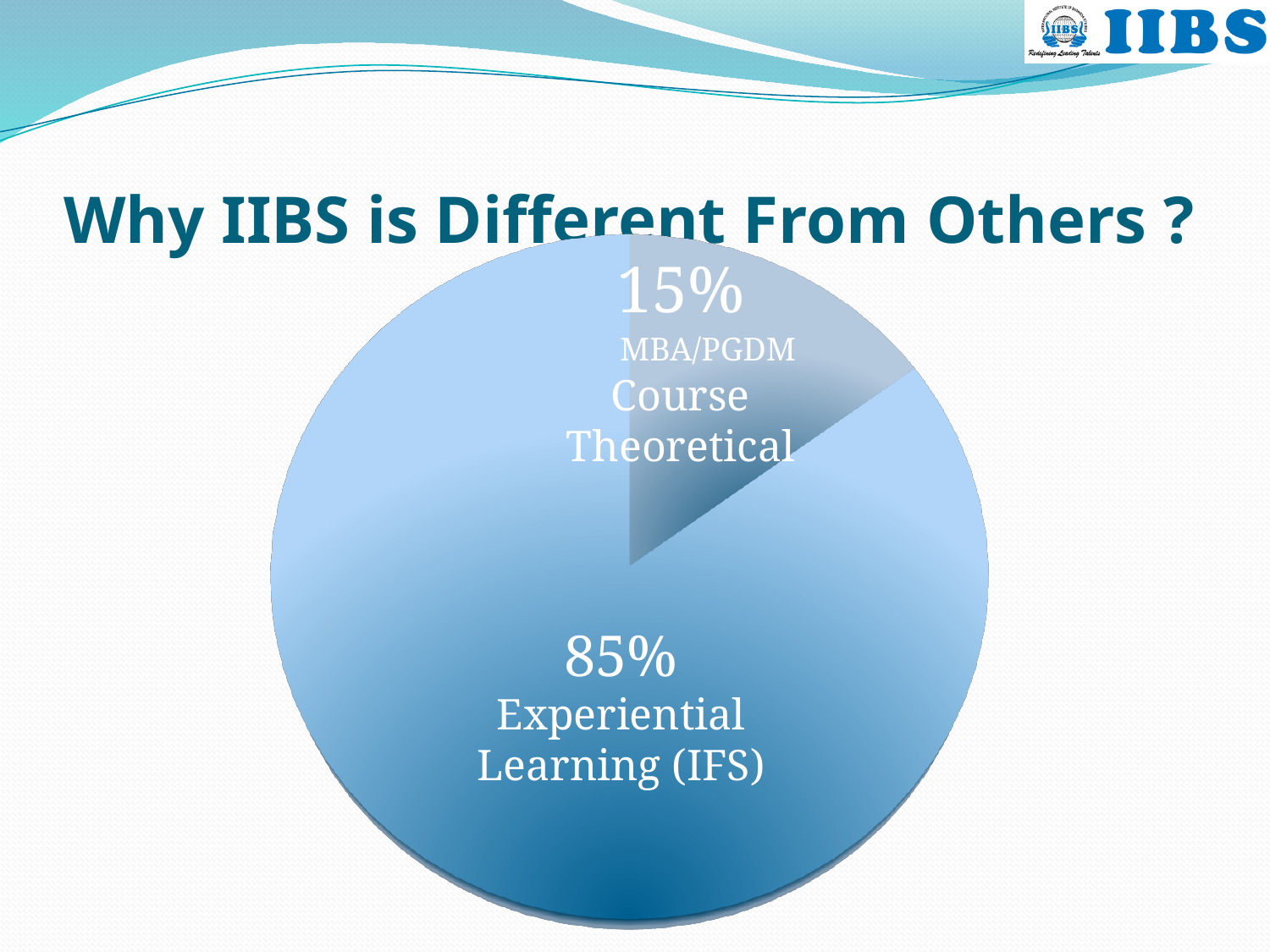
Which slice of the pie is the smallest? MBA/PGDM Course Theoretical What percentage of the pie is labelled MBA/PGDM Course Theoretical? 15% What percentage of the pie is labelled Experiential Learning (IFS)? 85% What is the difference in percentage points between the Experiential Learning (IFS) slice and the MBA/PGDM Course Theoretical slice? 70 What kind of chart is shown on the slide? pie chart How many slices does the pie chart have? 2 What share of the pie does the MBA/PGDM Course Theoretical slice represent? 15% What is the title of the slide containing the pie chart? Why IIBS is Different From Others ? Which slice of the pie is the largest? Experiential Learning (IFS) Which is larger: the Experiential Learning (IFS) slice or the MBA/PGDM Course Theoretical slice? Experiential Learning (IFS)